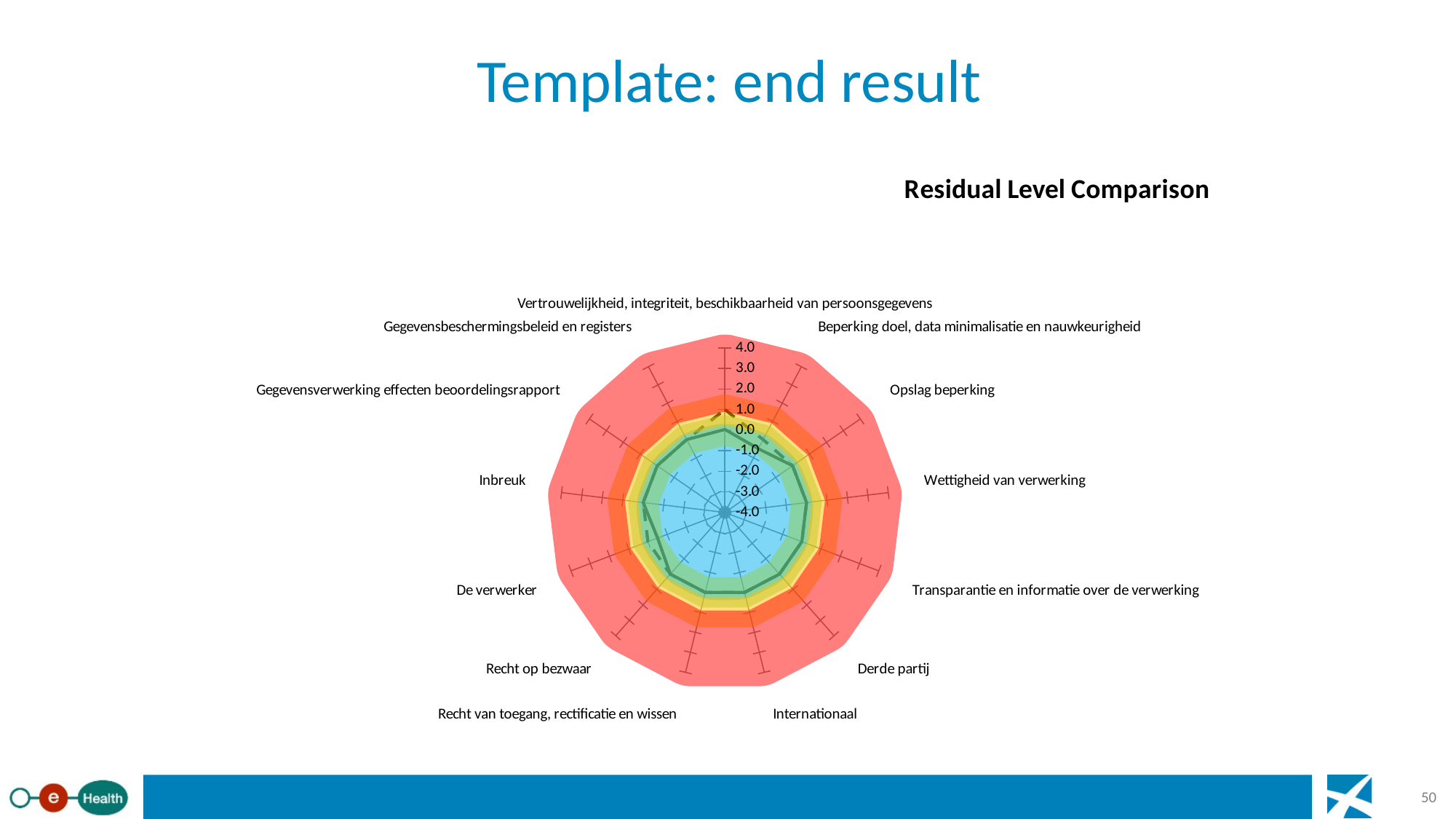
How many categories (axes) does the radar chart have? 13 Is the value of the dashed line for Vertrouwelijkheid, integriteit, beschikbaarheid van persoonsgegevens greater or less than 0.0? greater Is the value of the solid line for Internationaal greater or less than -3.0? greater What is the title of the chart on the slide? Residual Level Comparison Is the value of the solid line for Wettigheid van verwerking greater or less than 2.0? less What is the highest value shown on the radar chart's axis scale? 4.0 What kind of chart is shown on the slide? radar chart